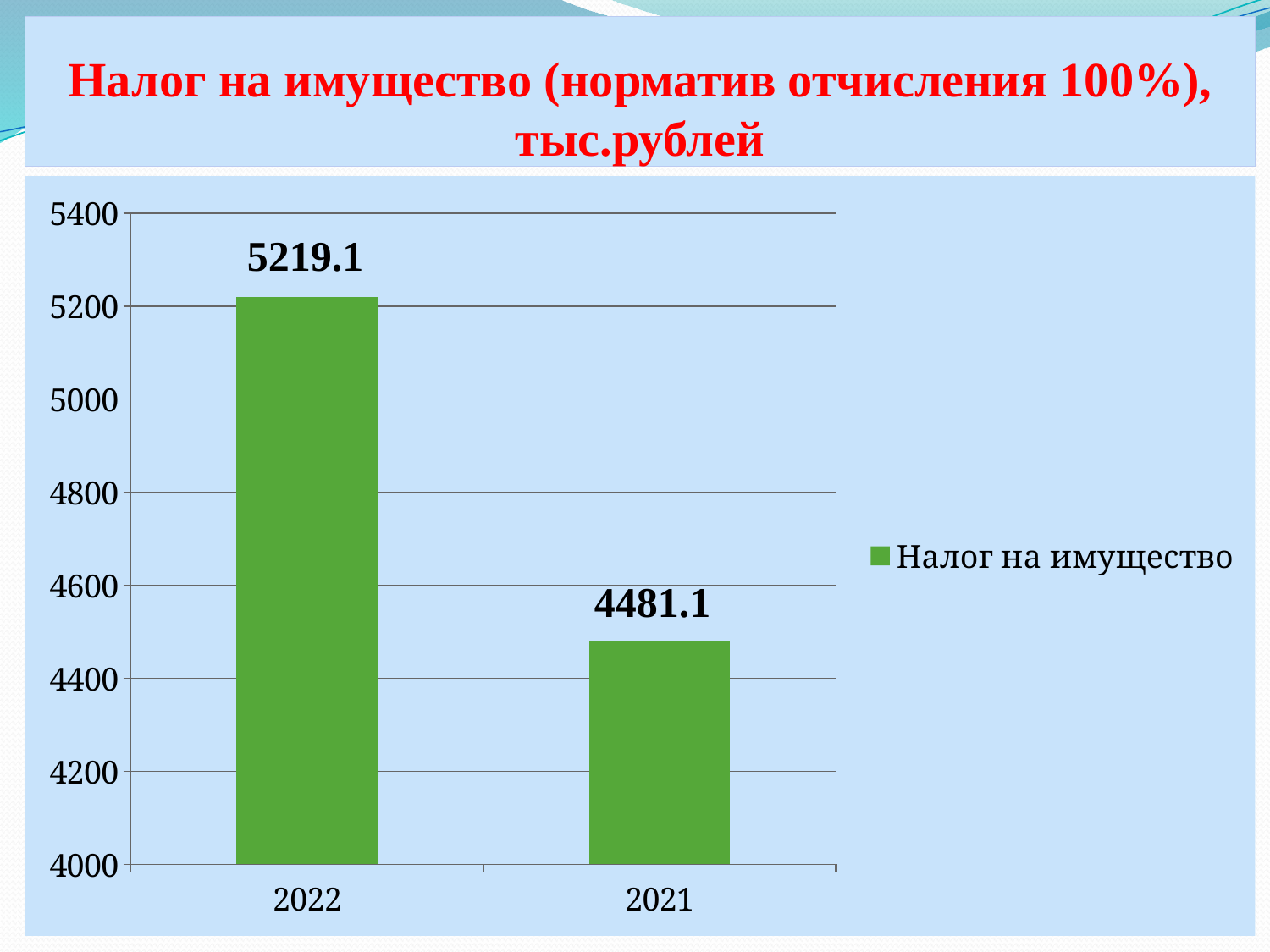
What is the value for 2021? 4481.1 Is the value for 2022 greater or less than 5000? greater Which year has the lowest value? 2021 Which year has the highest value? 2022 How many series does the legend list? 1 Which is larger, the value for 2022 or the value for 2021? 2022 Is the value for 2021 greater or less than 4600? less What kind of chart is shown on the slide? bar chart What series name is shown in the legend? Налог на имущество What is the value for 2022? 5219.1 What is the difference between the values for 2022 and 2021? 738 How many categories are shown on the x axis? 2